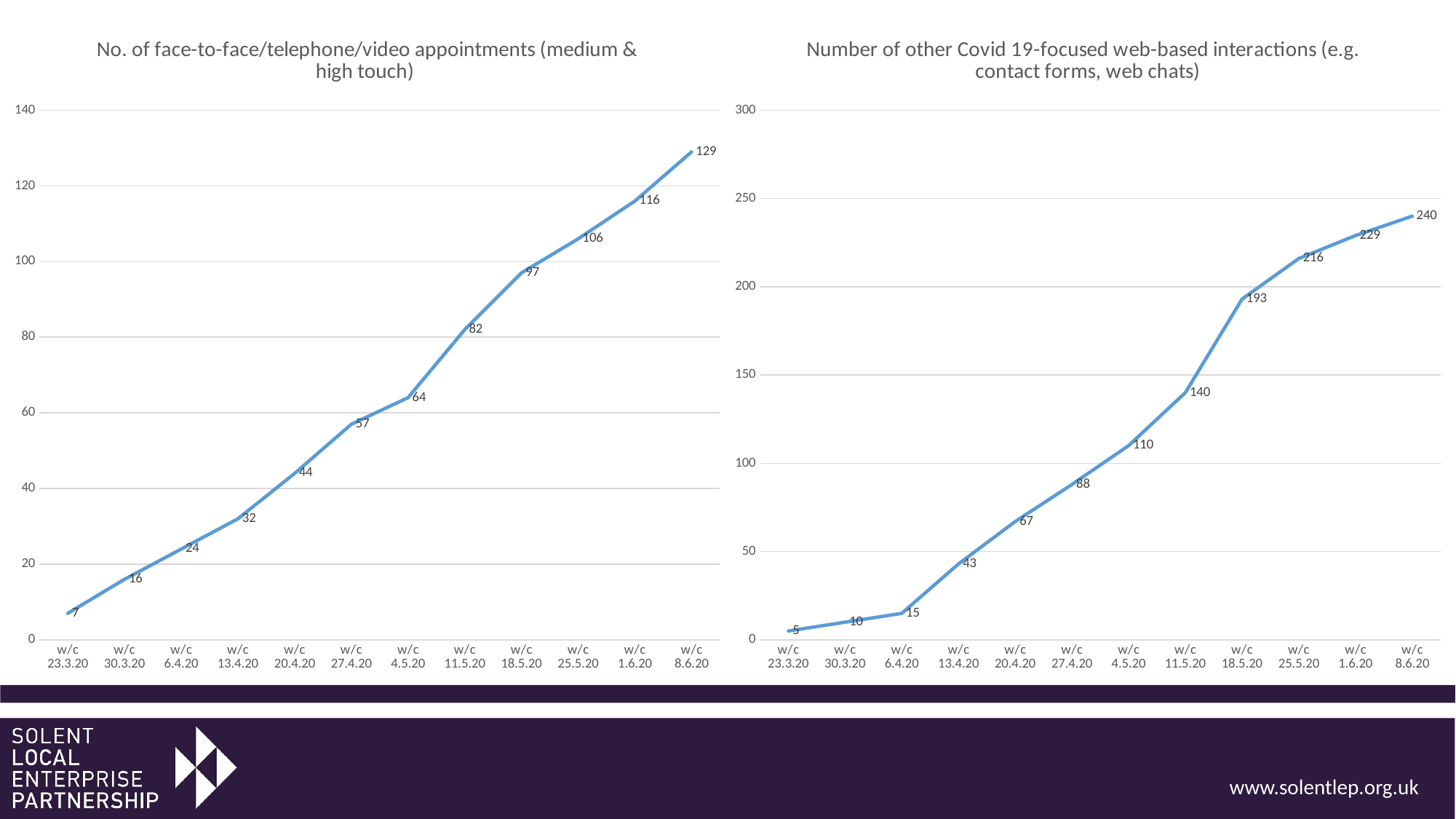
How many weeks are plotted on the x axis of the left chart (No. of face-to-face/telephone/video appointments)? 12 In the right chart (Number of other Covid 19-focused web-based interactions), what is the value for w/c 11.5.20? 140 In the right chart (Number of other Covid 19-focused web-based interactions), which is larger: the value for w/c 27.4.20 or w/c 4.5.20? w/c 4.5.20 What kind of chart is the right chart (Number of other Covid 19-focused web-based interactions)? Line chart In the left chart (No. of face-to-face/telephone/video appointments), what is the difference between the values for w/c 8.6.20 and w/c 1.6.20? 13 In the left chart (No. of face-to-face/telephone/video appointments), what is the value for w/c 18.5.20? 97 In the left chart (No. of face-to-face/telephone/video appointments), which week has the highest value? w/c 8.6.20 In the right chart (Number of other Covid 19-focused web-based interactions), do the values rise or fall from w/c 23.3.20 to w/c 8.6.20? Rise What is the title of the left chart? No. of face-to-face/telephone/video appointments (medium & high touch) In the left chart (No. of face-to-face/telephone/video appointments), is the value for w/c 25.5.20 greater or less than 100? greater In the right chart (Number of other Covid 19-focused web-based interactions), what is the difference between the values for w/c 18.5.20 and w/c 11.5.20? 53 In the right chart (Number of other Covid 19-focused web-based interactions), which week has the lowest value? w/c 23.3.20